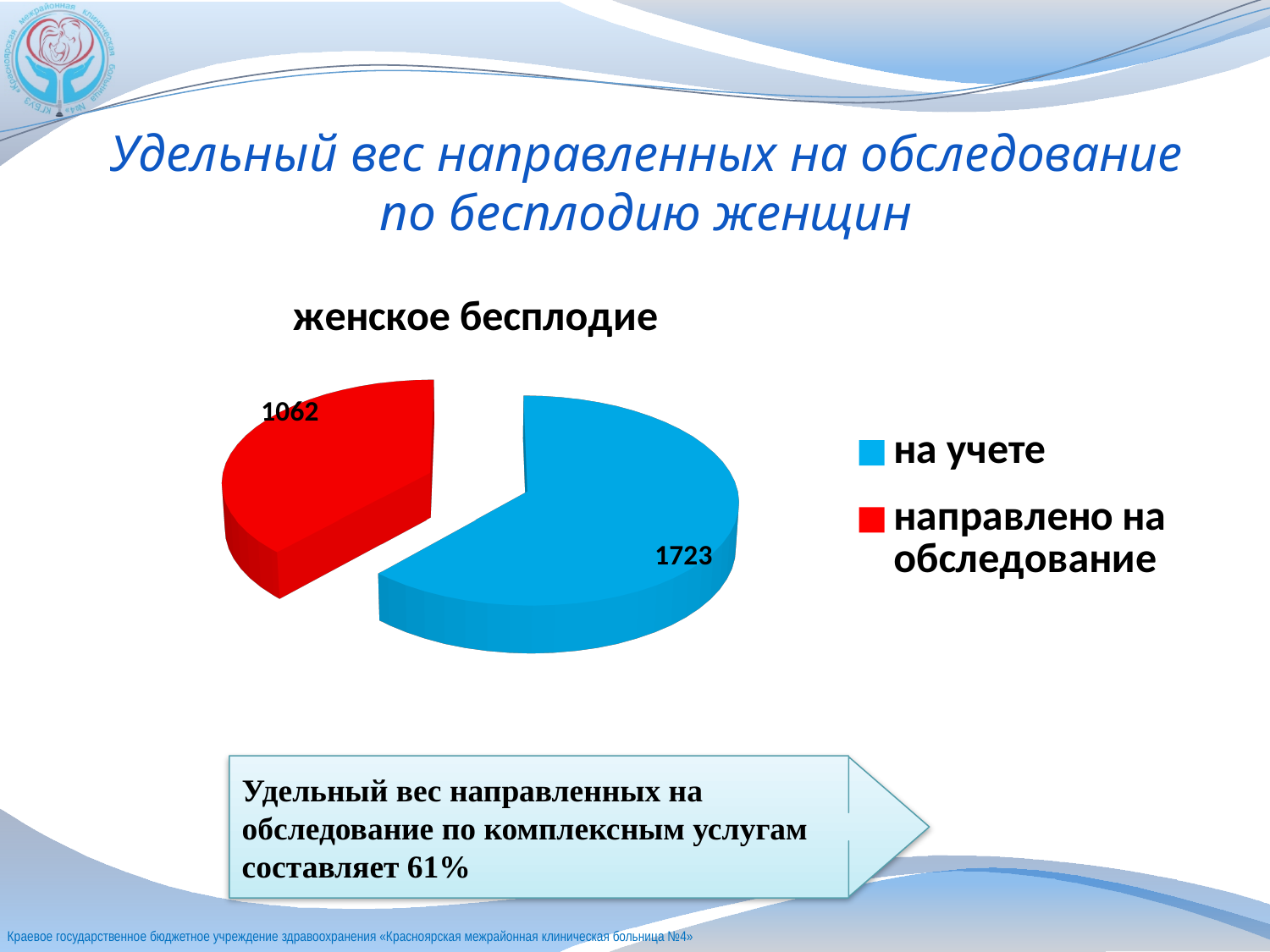
What colour is the slice for "направлено на обследование"? red What is the difference between the values for "на учете" and "направлено на обследование"? 661 What is the title of the chart? женское бесплодие How many slices does the pie chart have? 2 What is the value for "направлено на обследование"? 1062 What is the total of the two values shown in the pie chart? 2785 What type of chart is shown on the slide? pie chart Which category has the largest slice of the pie? на учете How many entries does the legend list? 2 Which category has the smallest slice of the pie? направлено на обследование What is the value for "на учете"? 1723 Which is larger: the value for "на учете" or the value for "направлено на обследование"? на учете